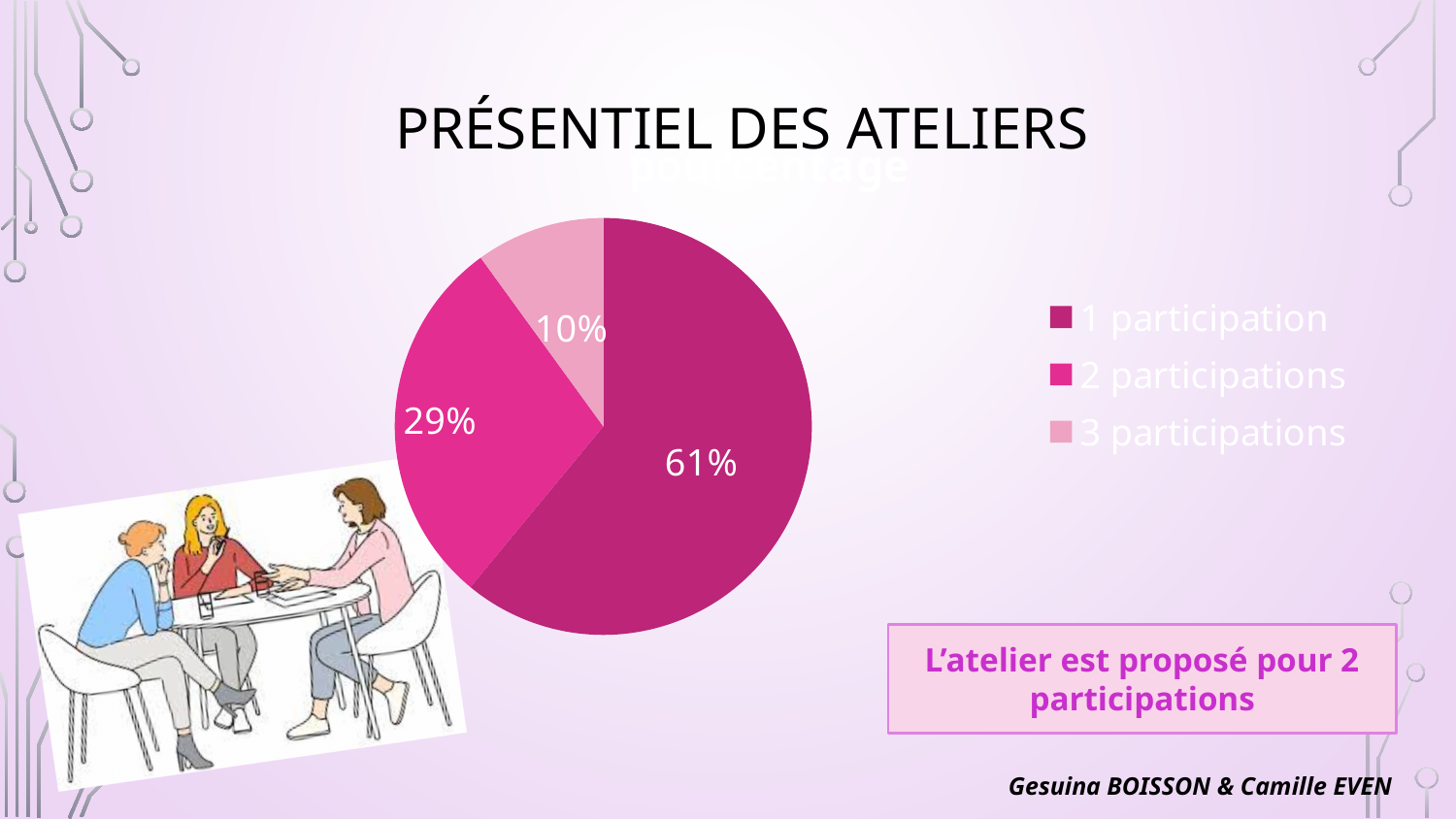
What percentage of the pie corresponds to "1 participation"? 61% Which slice is larger: "2 participations" or "3 participations"? 2 participations What is the difference in percentage points between the "1 participation" slice and the "2 participations" slice? 32 Which category has the smallest slice of the pie? 3 participations What percentage of the pie corresponds to "3 participations"? 10% How many entries does the legend list? 3 What kind of chart is shown on the slide? pie chart What is the title of the slide containing the pie chart? PRÉSENTIEL DES ATELIERS What percentage of the pie corresponds to "2 participations"? 29% Which category has the largest slice of the pie? 1 participation How many slices does the pie chart have? 3 What is the difference in percentage points between the "2 participations" slice and the "3 participations" slice? 19